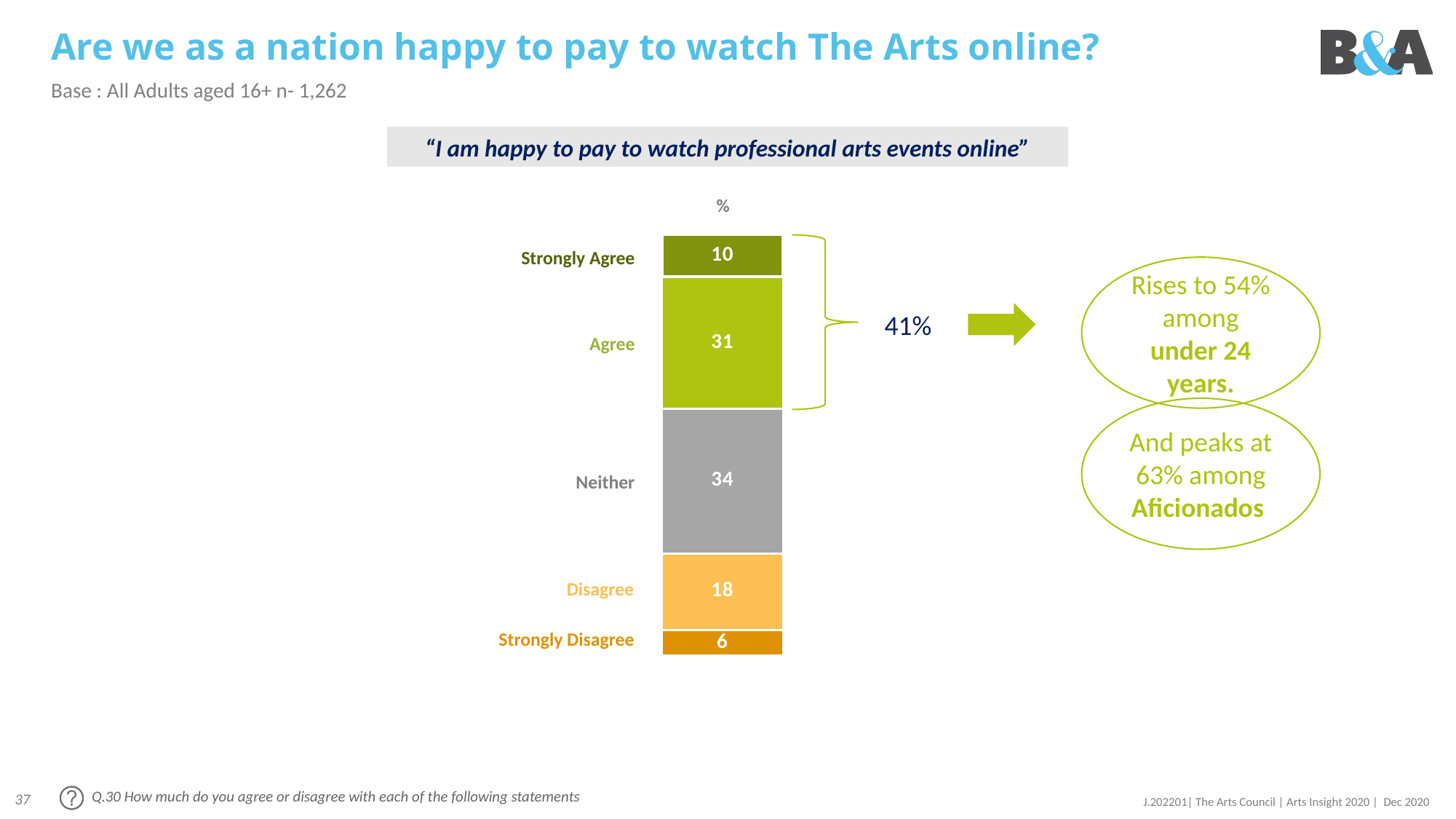
Which response category has the smallest share? Strongly Disagree How many response categories are shown in the stacked bar? 5 What is the difference between the Agree and Disagree percentages? 13 What percentage of respondents Disagree with the statement? 18 What kind of chart is used to show the responses? Stacked bar chart What percentage of respondents answered Neither? 34 What percentage of respondents Agree with the statement? 31 Which is larger, the share for Agree or the share for Neither? Neither What percentage of respondents Strongly Disagree? 6 Which response category has the largest share? Neither What combined percentage is shown for Strongly Agree and Agree together? 41% What percentage of respondents Strongly Agree that they are happy to pay to watch professional arts events online? 10